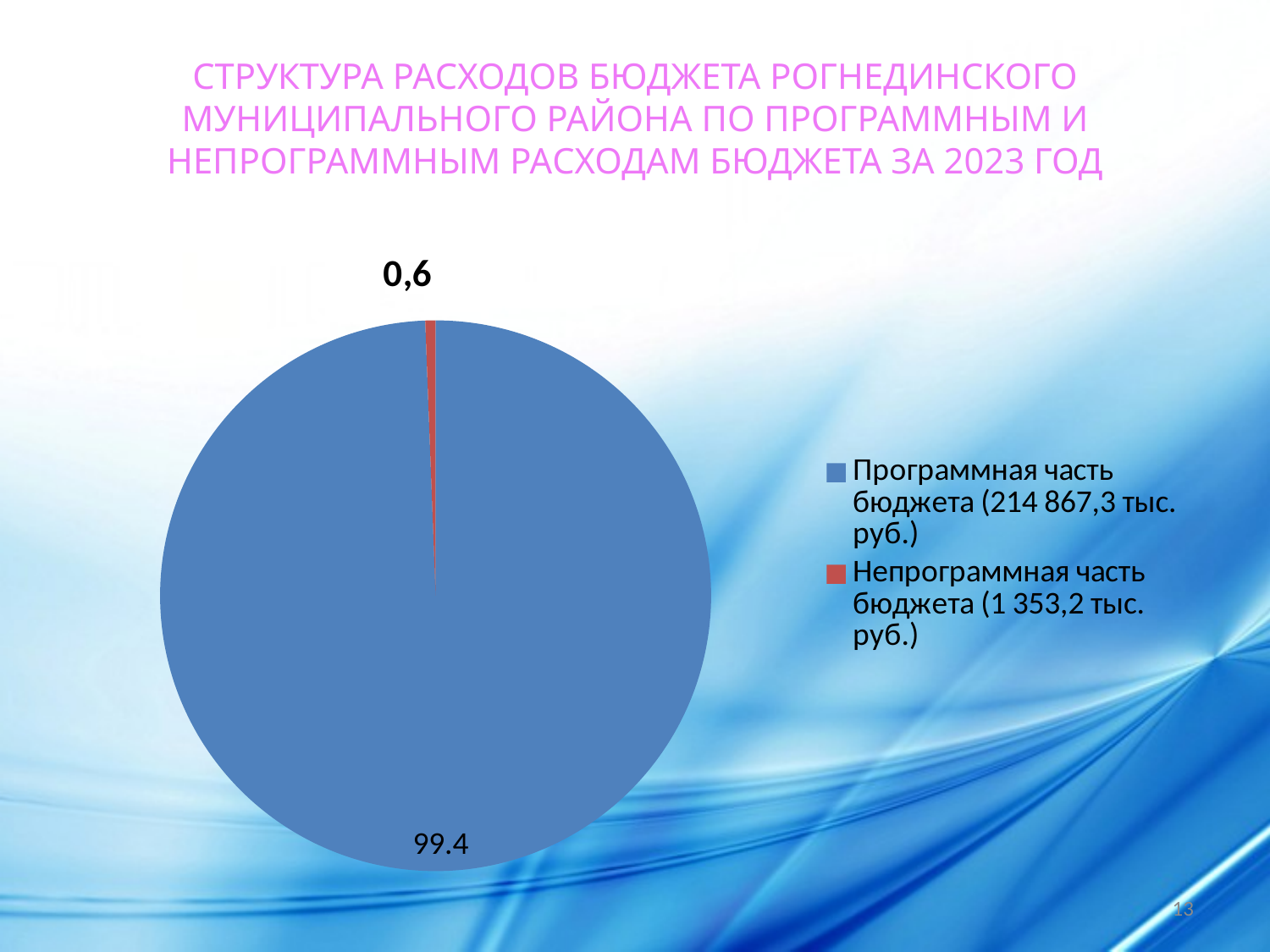
What amount in thousand rubles does the legend give for 'Программная часть бюджета'? 214 867,3 тыс. руб. What is the difference between the values of the two slices (99.4 and 0,6)? 98.8 What value is shown for the slice 'Программная часть бюджета'? 99.4 How many slices does the pie chart have? 2 How many entries does the legend list? 2 What colour is the slice for 'Непрограммная часть бюджета'? red What value is shown for the slice 'Непрограммная часть бюджета'? 0,6 Which is larger: the slice for 'Программная часть бюджета' or the slice for 'Непрограммная часть бюджета'? Программная часть бюджета Which slice is the smallest in the pie chart? Непрограммная часть бюджета What kind of chart is shown on the slide? pie chart Which slice is the largest in the pie chart? Программная часть бюджета